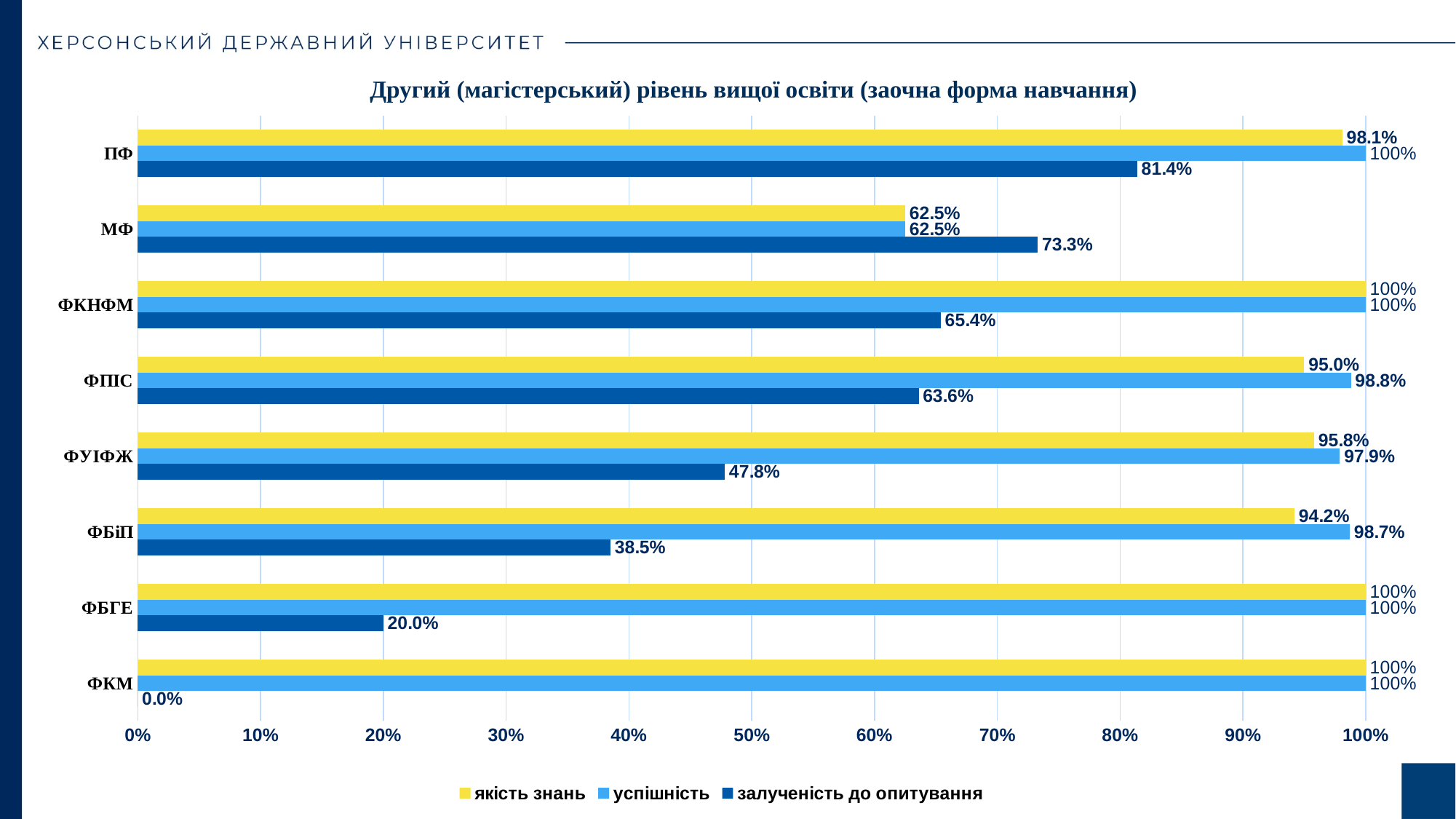
What is the value of успішність for ФПІС? 98.8% How many series does the legend list? 3 Which category has the lowest value for якість знань? МФ Which category has the lowest value for залученість до опитування? ФКМ What is the difference between успішність and залученість до опитування for ФБіП? 60.2% Which is larger for ФУІФЖ: якість знань or успішність? успішність How many categories (faculties) are shown on the chart? 8 Which category has the highest value for залученість до опитування? ПФ What is the value of якість знань for МФ? 62.5% What is the value of залученість до опитування for ПФ? 81.4% What type of chart is shown on the slide? bar chart What is the title of the chart? Другий (магістерський) рівень вищої освіти (заочна форма навчання)